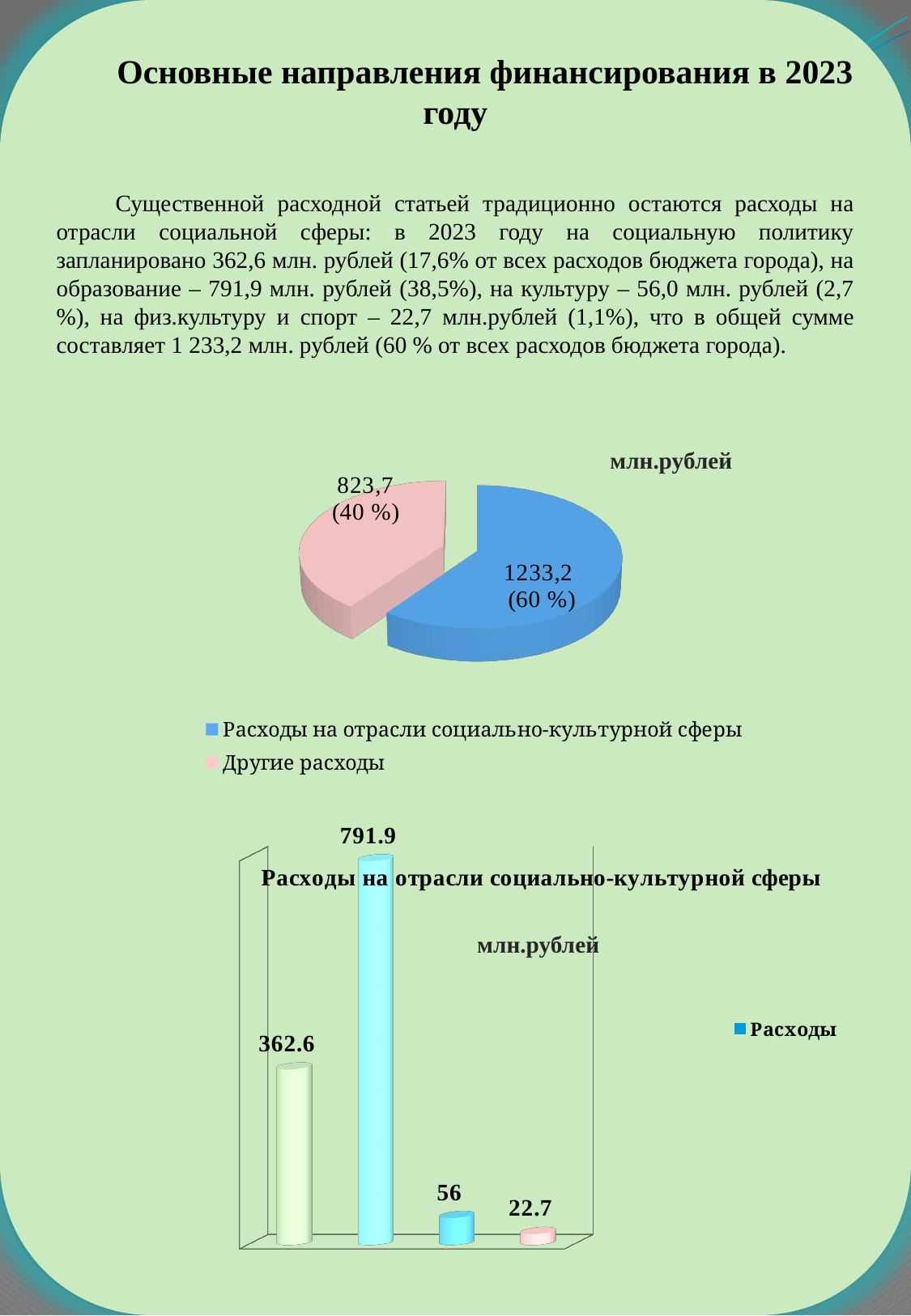
How many slices does the pie chart have? 2 In the pie chart, what unit is indicated next to the chart? млн.рублей In the bottom bar chart, what is the value of the tallest bar? 791.9 In the pie chart, what share does 'Расходы на отрасли социально-культурной сферы' take? 60 % What kind of chart is the bottom chart titled 'Расходы на отрасли социально-культурной сферы'? bar chart In the bottom bar chart, what is the difference between the second bar (791.9) and the first bar (362.6)? 429.3 In the bottom bar chart, what is the value of the shortest bar? 22.7 In the pie chart, what is the value for 'Другие расходы'? 823,7 In the pie chart, what share does 'Другие расходы' take? 40 % In the pie chart, which slice is larger: 'Расходы на отрасли социально-культурной сферы' or 'Другие расходы'? Расходы на отрасли социально-культурной сферы In the pie chart, what is the value for 'Расходы на отрасли социально-культурной сферы'? 1233,2 What kind of chart is the top chart on the slide? pie chart